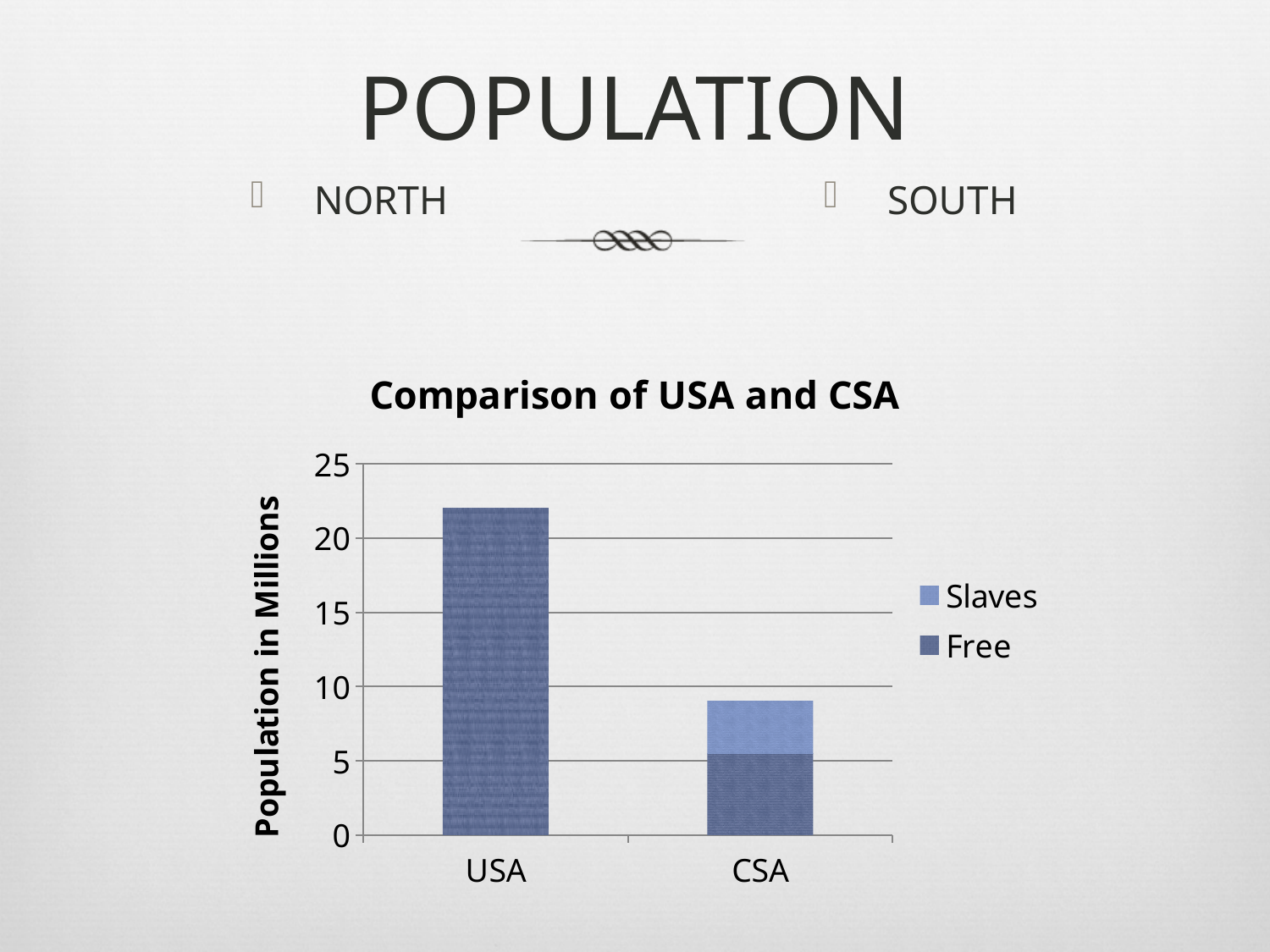
Which category has the lowest total population? CSA How many series does the legend list? 2 Which category has the highest total population? USA Which category has the taller bar, USA or CSA? USA How many categories are shown on the x axis? 2 Is the total value for USA greater or less than 20? greater Is the Free value for CSA greater or less than 10? less Is the total value for USA greater or less than 15? greater What is the title of the chart? Comparison of USA and CSA What is the label of the y axis? Population in Millions What kind of chart is shown on the slide? bar chart